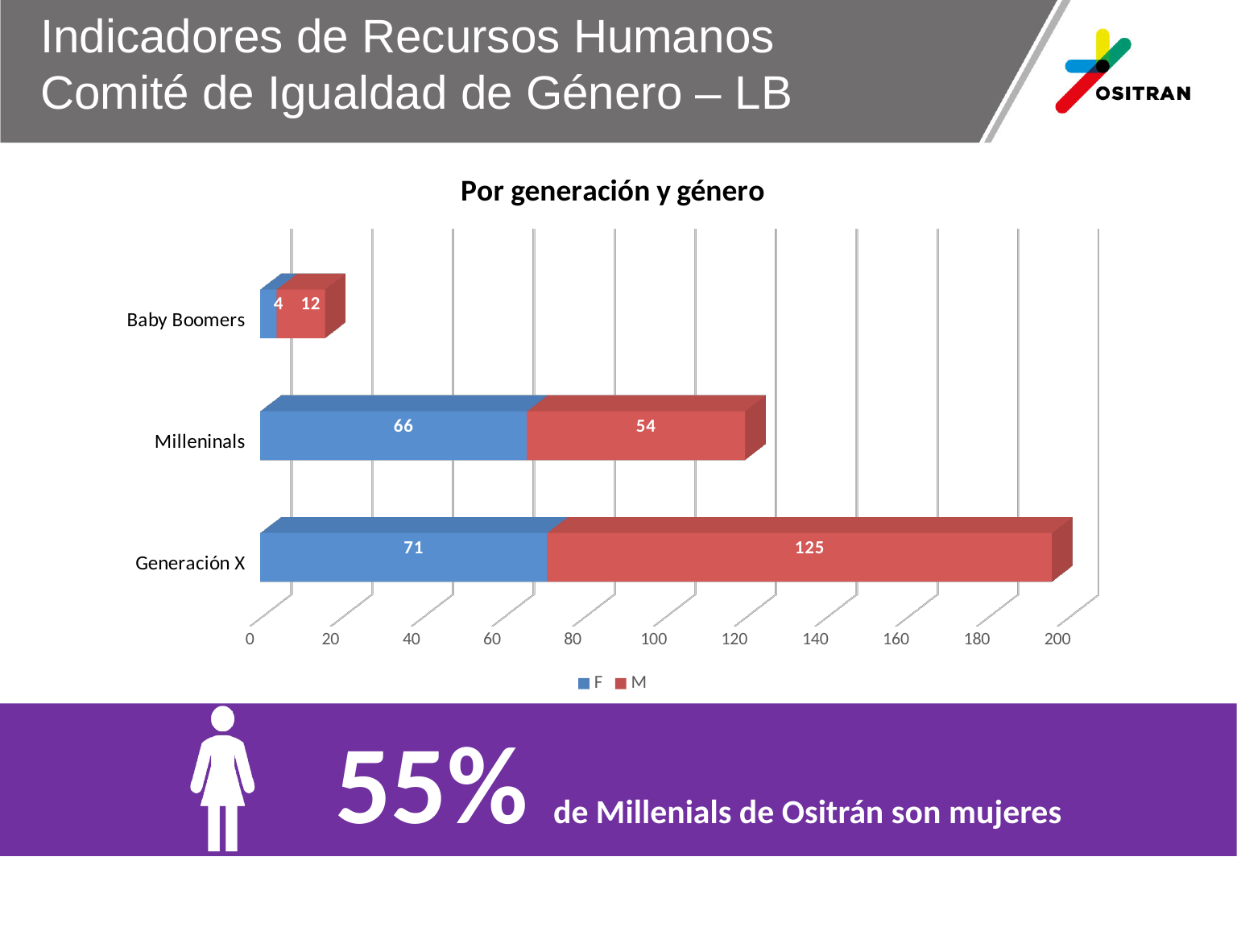
How many categories are shown on the chart? 3 Which category has the lowest value for F? Baby Boomers Which category has the highest value for M? Generación X What is the difference between the M and F values for Generación X? 54 What is the total of the stacked bar for Baby Boomers? 16 What is the value for F in the Baby Boomers category? 4 What is the value for M in the Milleninals category? 54 How many series does the legend list? 2 What is the value for F in the Generación X category? 71 Which is larger for Milleninals, the F value or the M value? F What is the total of the stacked bar for Generación X? 196 What type of chart is shown? Bar chart